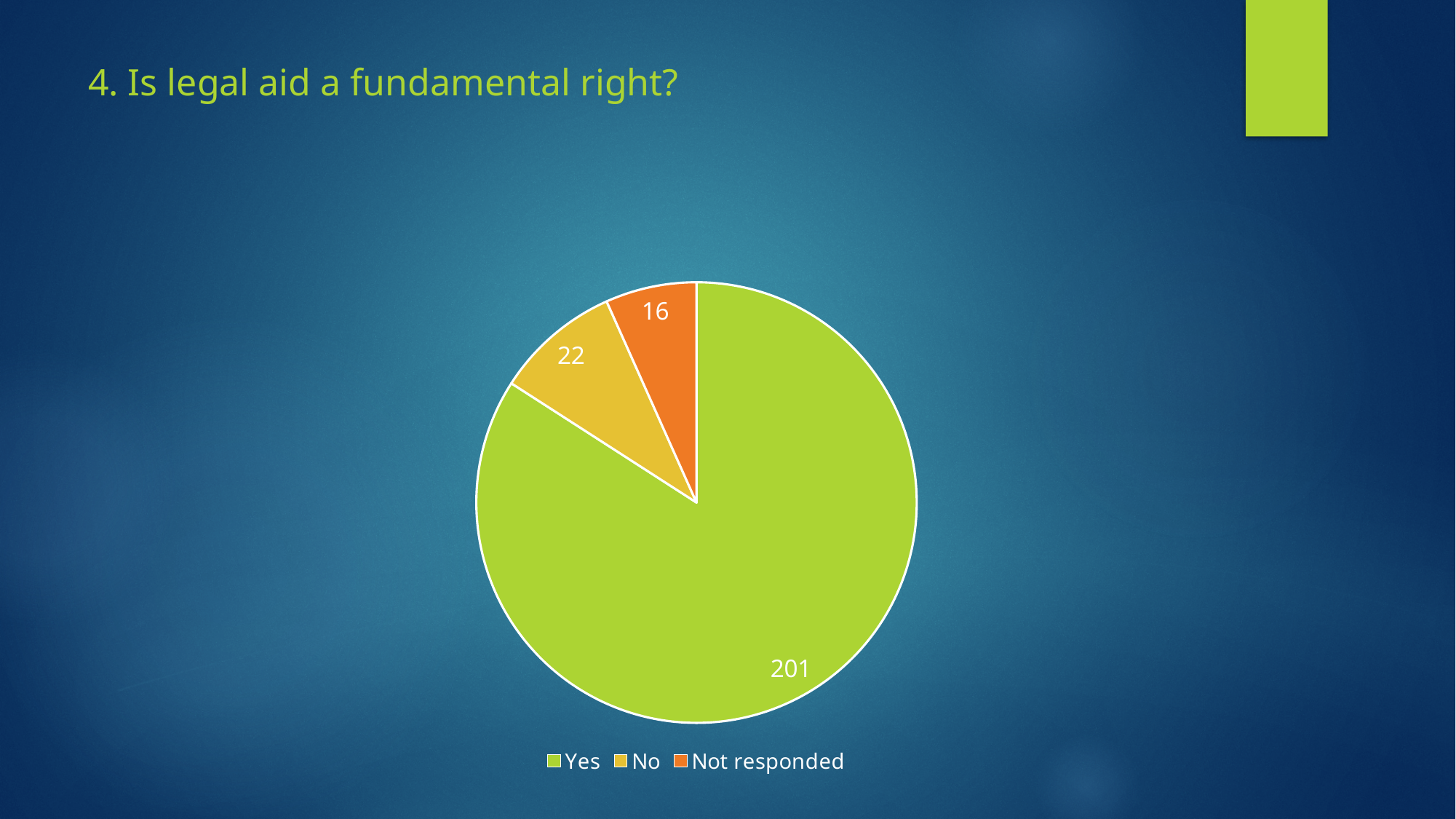
What is the value for No? 22 Which category has the largest slice? Yes What is the value for Not responded? 16 What is the value for Yes? 201 Which category has the smallest slice? Not responded Which is larger, the value for No or the value for Not responded? No What is the difference between the values for Yes and No? 179 What is the title of the slide containing the chart? 4. Is legal aid a fundamental right? What is the difference between the values for No and Not responded? 6 How many slices does the pie chart have? 3 What is the total of all slices in the pie chart? 239 What kind of chart is shown on the slide? Pie chart